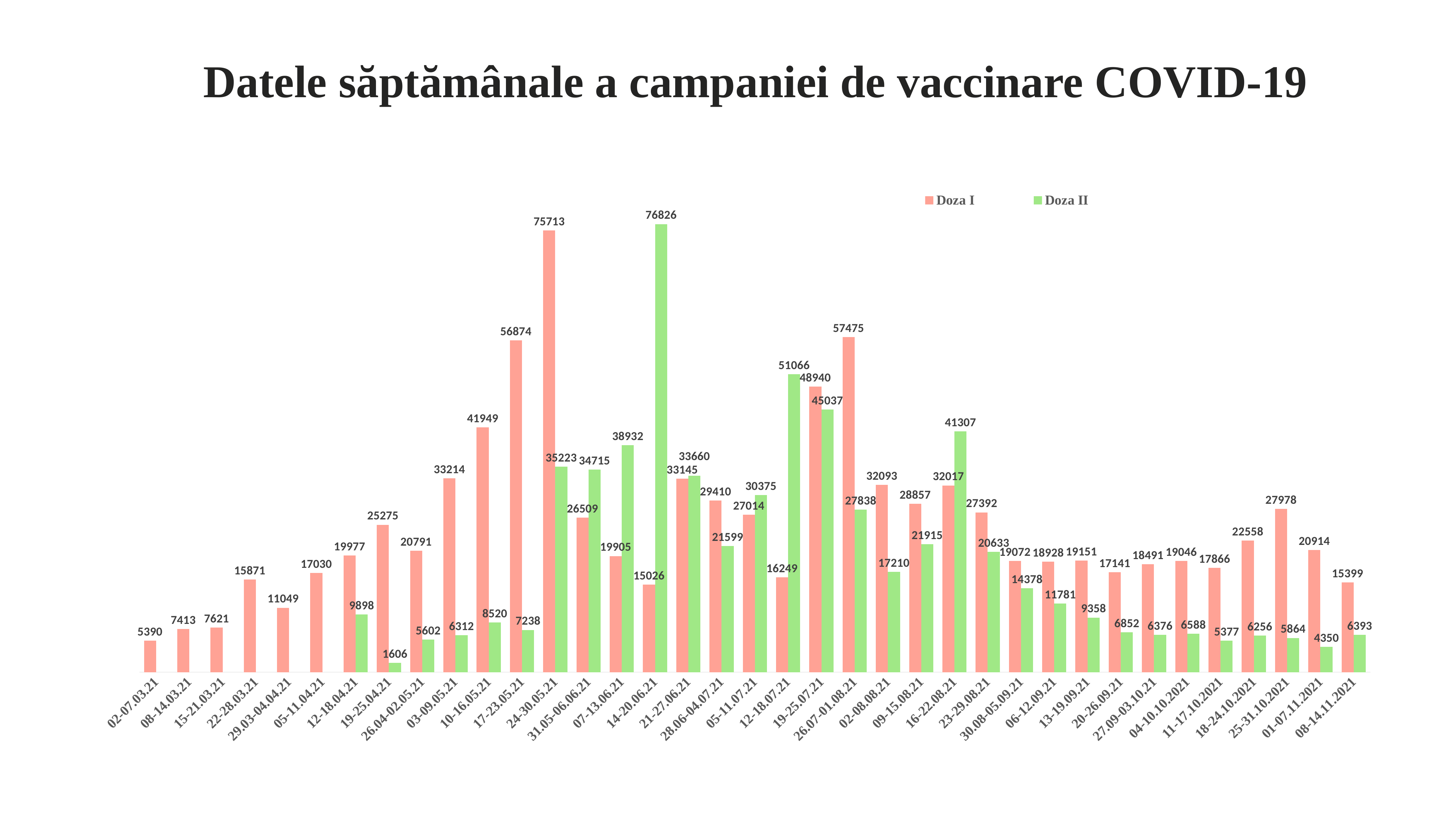
In the week 12-18.07.21, which is larger, Doza I or Doza II? Doza II What is the difference between Doza I and Doza II in the week 26.07-01.08.21? 29637 What is the Doza I value for the week 08-14.11.2021? 15399 What is the Doza II value for the week 14-20.06.21? 76826 Which week has the lowest Doza I value? 02-07.03.21 Which week has the lowest Doza II value? 19-25.04.21 What is the title of the chart? Datele săptămânale a campaniei de vaccinare COVID-19 What type of chart is shown on the slide? bar chart Do the Doza I values rise or fall from the week 02-07.03.21 to the week 24-30.05.21? rise How many series does the legend list? 2 What is the Doza I value for the week 24-30.05.21? 75713 Which week has the highest Doza II value? 14-20.06.21